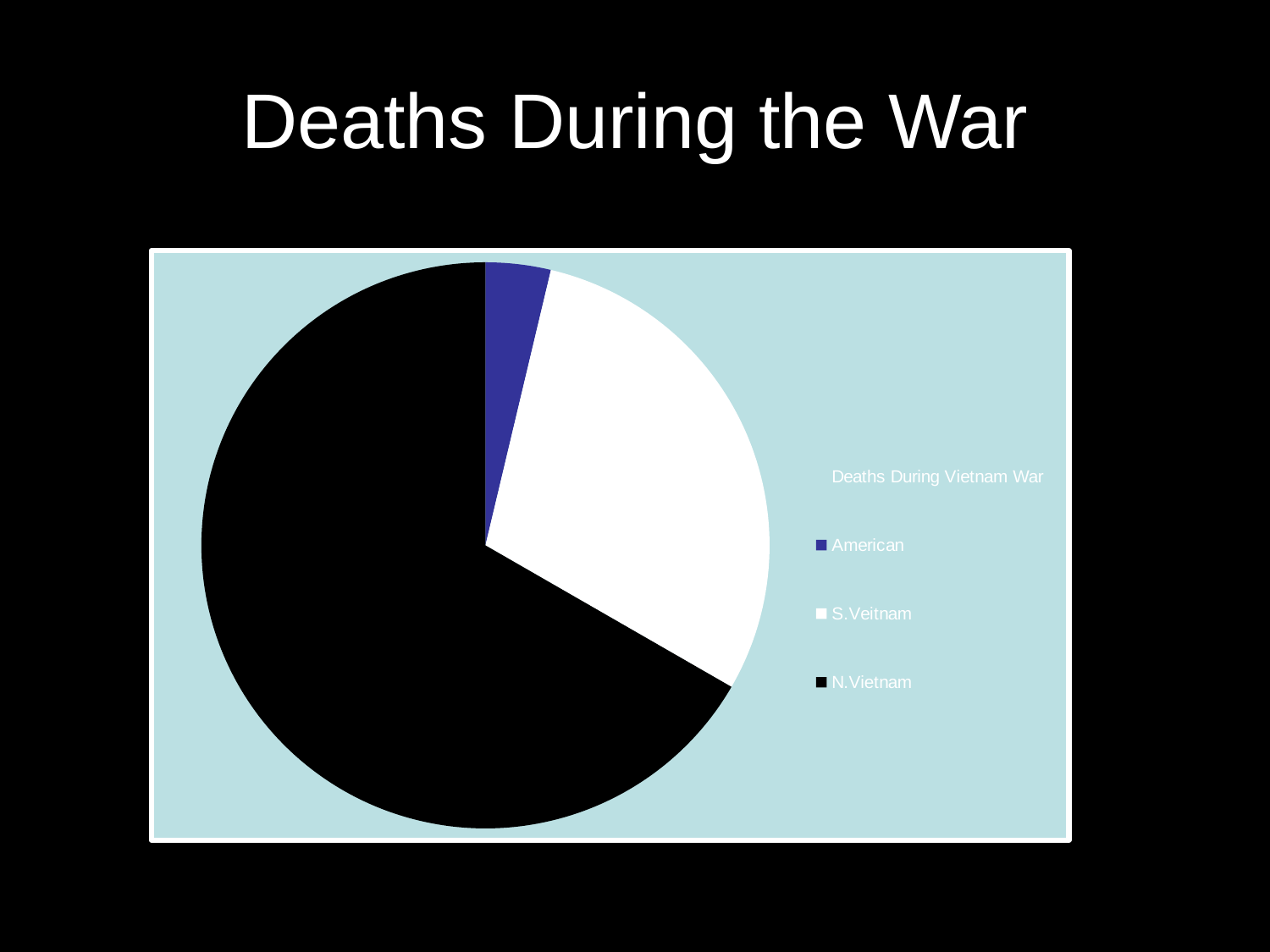
What colour is the N.Vietnam slice in the pie chart? black Which slice is larger in the pie chart, S.Veitnam or American? S.Veitnam Which category has the smallest slice of the pie chart? American Which slice is larger in the pie chart, N.Vietnam or S.Veitnam? N.Vietnam How many entries does the legend of the pie chart list? 3 How many slices does the pie chart have? 3 Which category has the largest slice of the pie chart? N.Vietnam What is the title shown above the legend of the pie chart? Deaths During Vietnam War What kind of chart is shown on the slide? pie chart